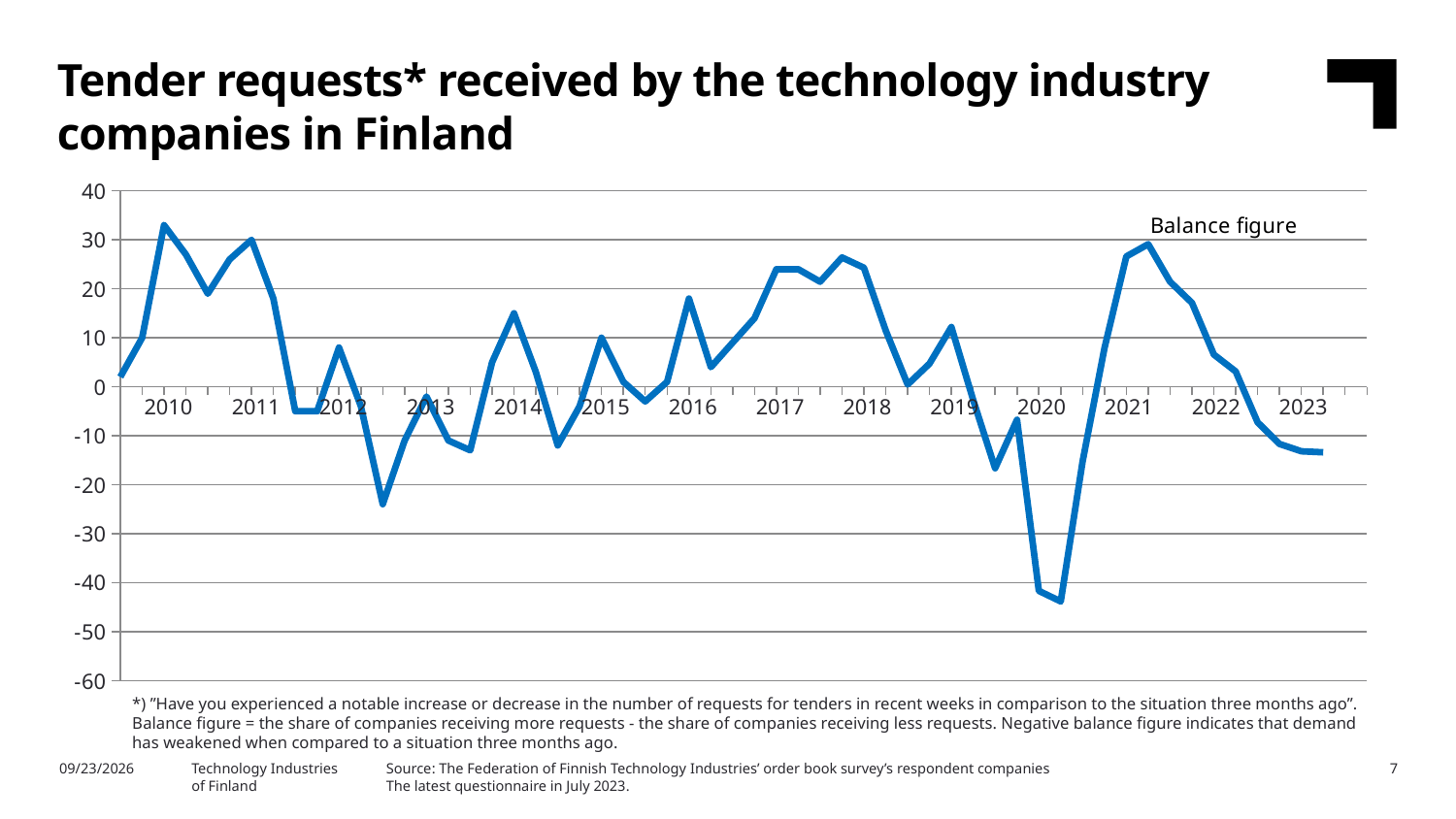
In which year does the balance figure reach its lowest point? 2020 What is the title of the chart on the slide? Tender requests* received by the technology industry companies in Finland Is the last plotted value in 2023 greater or less than 0? less What is the name of the series plotted in the chart? Balance figure Is the lowest value of the balance figure in 2020 greater or less than -40? less Is the highest value of the balance figure in 2010 greater or less than 30? greater How many series does the chart plot? 1 In which year does the balance figure reach its highest point? 2010 Which is higher: the peak of the balance figure in 2018 or the peak in 2016? 2018 Does the balance figure rise or fall from its 2021 peak to the end of 2023? Fall What type of chart is shown on the slide? Line chart How many years are labelled on the x axis? 14